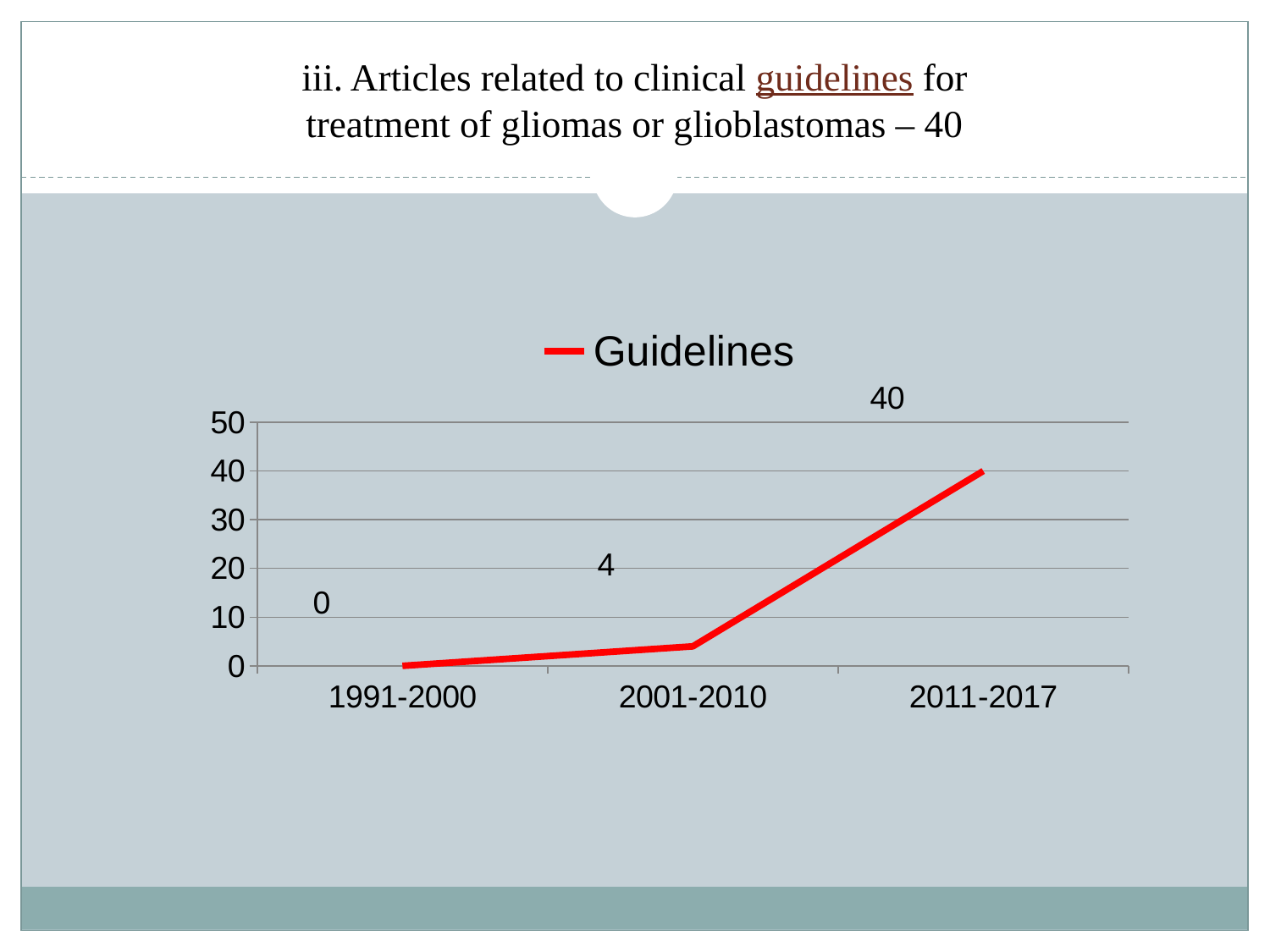
How many periods are shown on the x axis? 3 What is the value for 2001-2010? 4 What is the value for 2011-2017? 40 What is the difference between the values for 2011-2017 and 2001-2010? 36 Is the value for 2011-2017 greater or less than 30? greater What is the value for 1991-2000? 0 Do the values rise or fall from 1991-2000 to 2011-2017? rise Which period has the highest value? 2011-2017 What kind of chart is shown? line chart Which period has the lowest value? 1991-2000 Which is larger, the value for 2001-2010 or the value for 1991-2000? 2001-2010 How many series does the legend list? 1